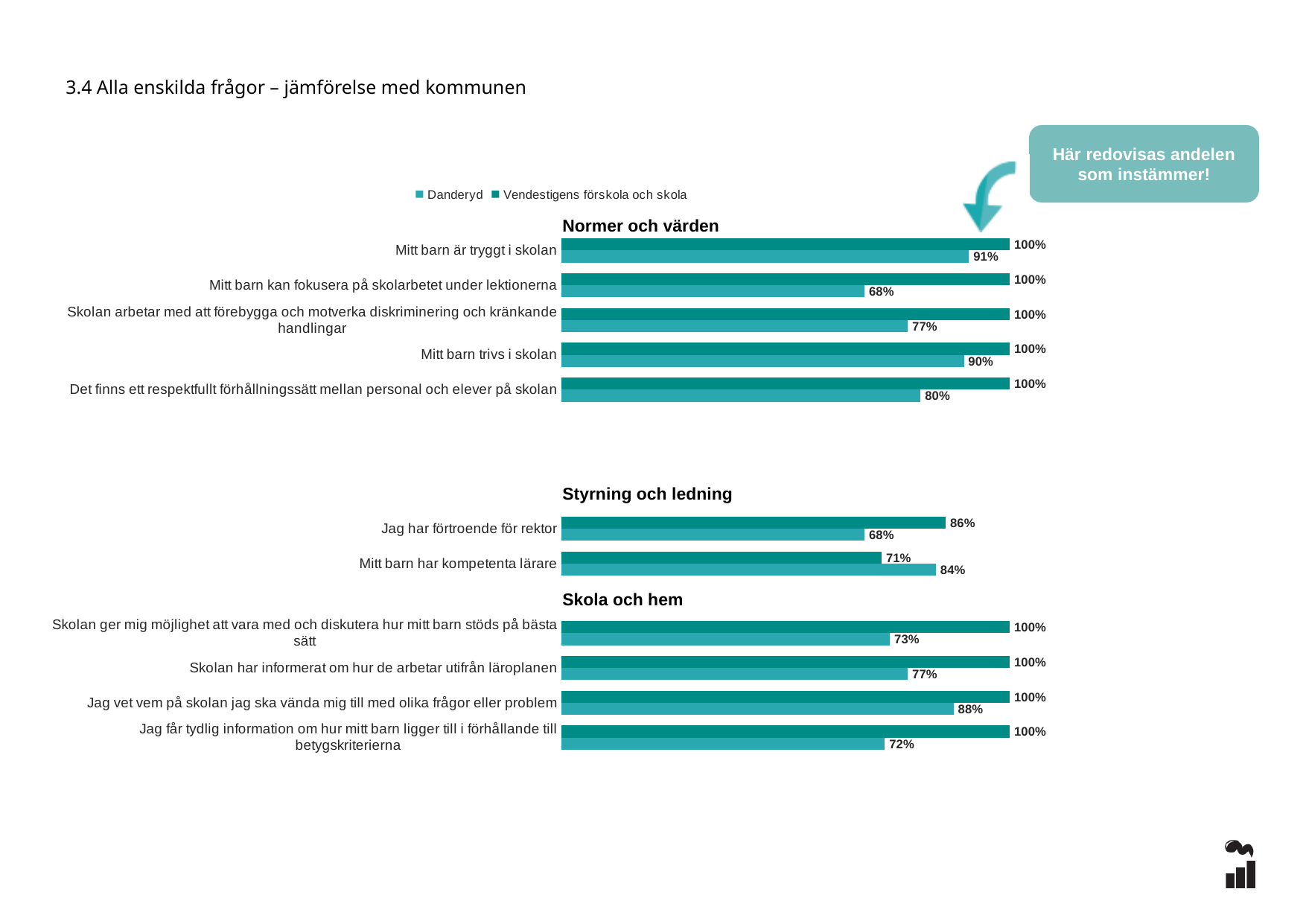
What is the value for Danderyd for "Jag vet vem på skolan jag ska vända mig till med olika frågor eller problem"? 88% Which series has the higher value for "Mitt barn har kompetenta lärare", Danderyd or Vendestigens förskola och skola? Danderyd What is the difference between the Vendestigens förskola och skola value and the Danderyd value for "Jag har förtroende för rektor"? 18% What kind of chart is shown on the slide? Bar chart What is the value for Danderyd for "Mitt barn är tryggt i skolan"? 91% What is the value for Vendestigens förskola och skola for "Jag har förtroende för rektor"? 86% How many series does the legend list? 2 Among the Danderyd values in the "Normer och värden" section, which question has the lowest value? Mitt barn kan fokusera på skolarbetet under lektionerna What is the value for Danderyd for "Mitt barn har kompetenta lärare"? 84% Among the Danderyd values in the "Skola och hem" section, which question has the highest value? Jag vet vem på skolan jag ska vända mig till med olika frågor eller problem How many questions are shown in the "Skola och hem" section? 4 What is the difference between the Vendestigens förskola och skola value and the Danderyd value for "Mitt barn kan fokusera på skolarbetet under lektionerna"? 32%